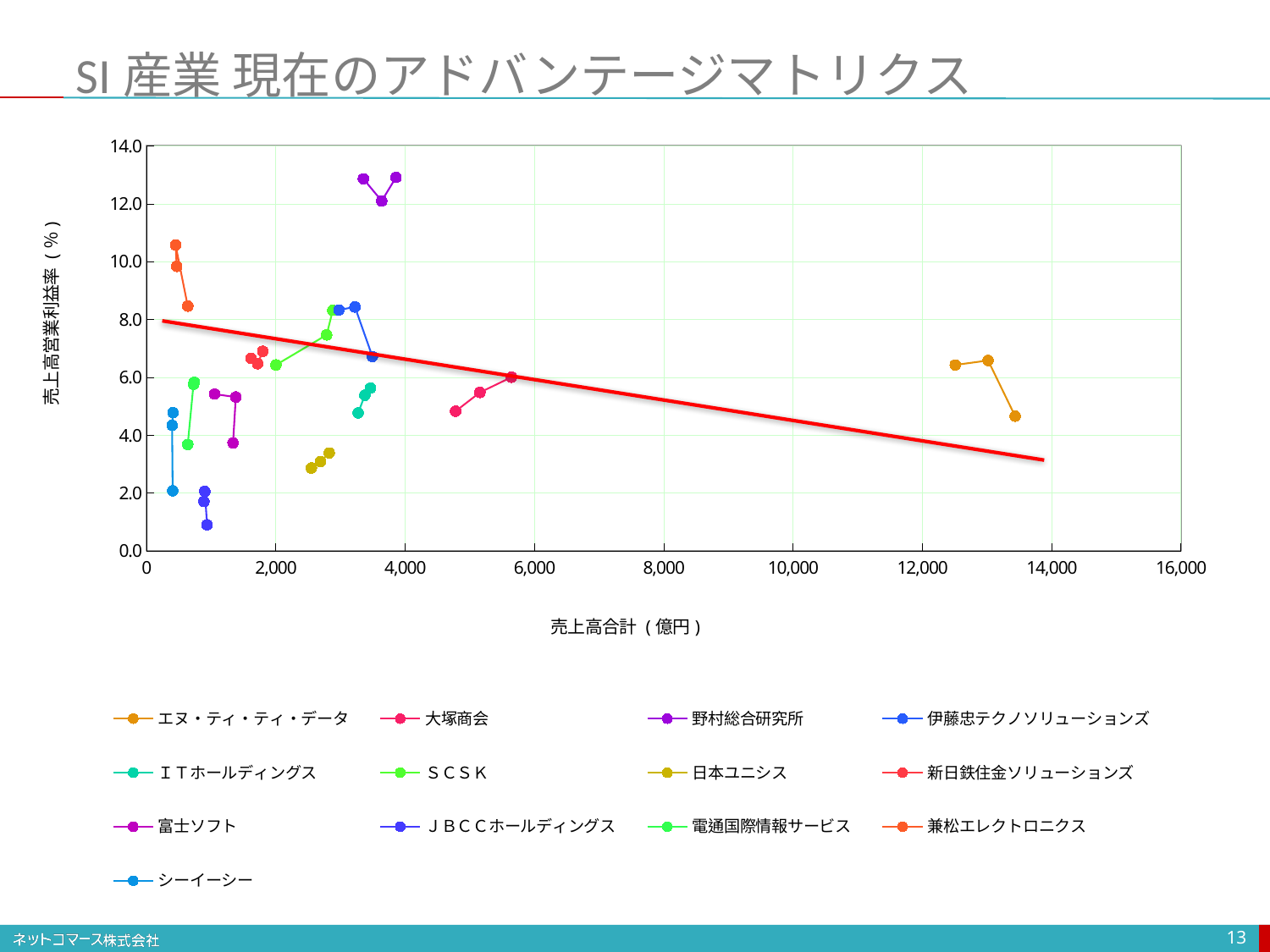
Are the 売上高合計 values for エヌ・ティ・ティ・データ greater or less than 12,000? greater Which series has the largest 売上高合計 (億円) values on the chart? エヌ・ティ・ティ・データ Are the 売上高営業利益率 values for ＪＢＣＣホールディングス greater or less than 4.0? less What kind of chart is shown on the slide? scatter chart Which series has higher 売上高営業利益率 values, 野村総合研究所 or 大塚商会? 野村総合研究所 Are the 売上高営業利益率 values for 兼松エレクトロニクス greater or less than 8.0? greater Does the red trend line rise or fall as 売上高合計 increases? fall What is the title of the x axis? 売上高合計（億円） Which series has the lowest 売上高営業利益率 (%) point on the chart? ＪＢＣＣホールディングス Which series reaches the highest 売上高営業利益率 (%) on the chart? 野村総合研究所 How many series does the legend list? 13